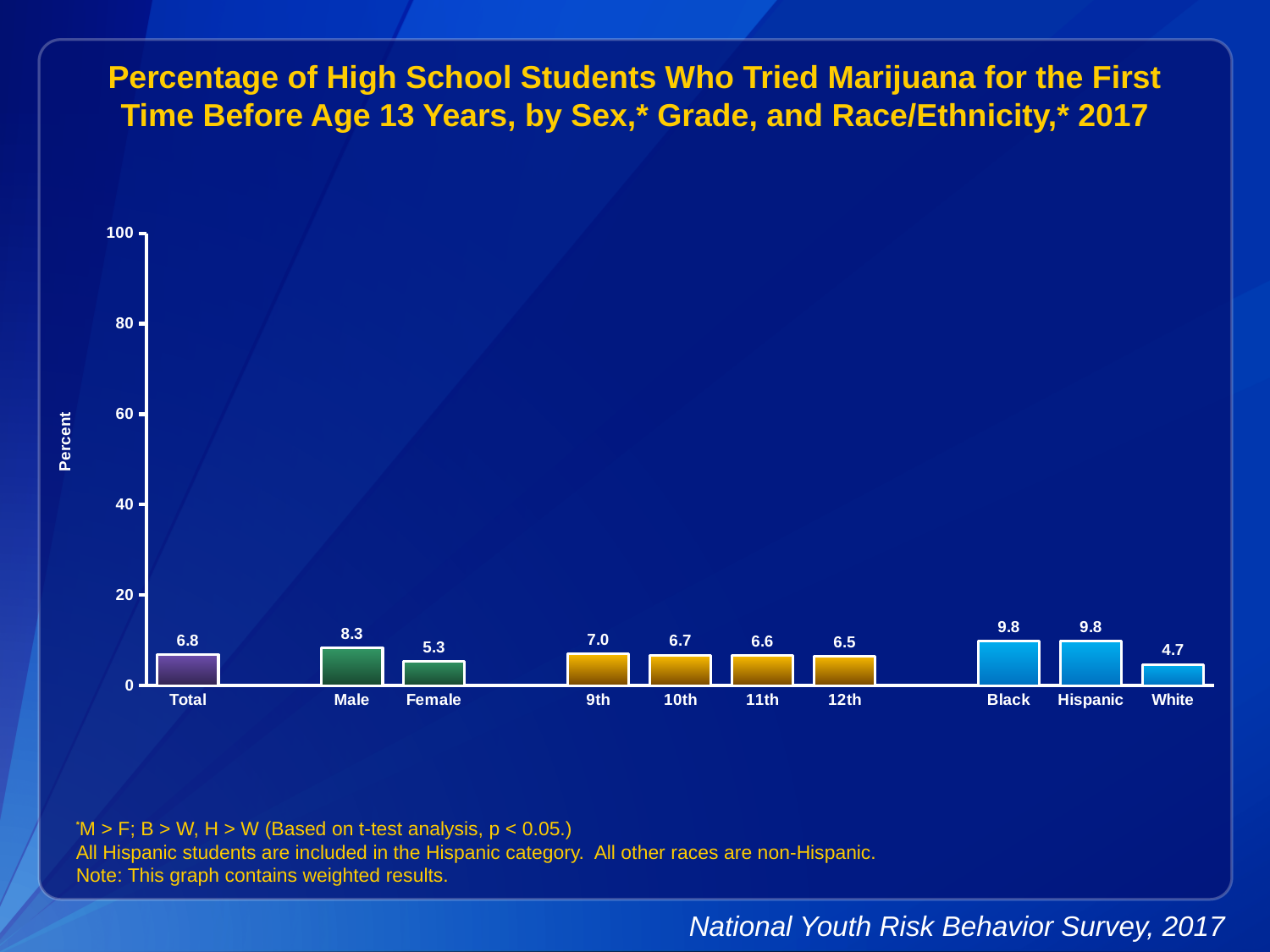
What is the value for 12th grade? 6.5 Do the values rise or fall from 9th grade to 12th grade? fall Which category has the lowest value? White What is the value for Total? 6.8 What is the difference between the Male and Female values? 3.0 Is the value for Hispanic greater or less than 20? less What kind of chart is this? bar chart What is the value for Male? 8.3 Which is larger, the value for Black or the value for White? Black What is the label on the y axis? Percent What is the value for White? 4.7 How many categories are shown on the x axis? 10